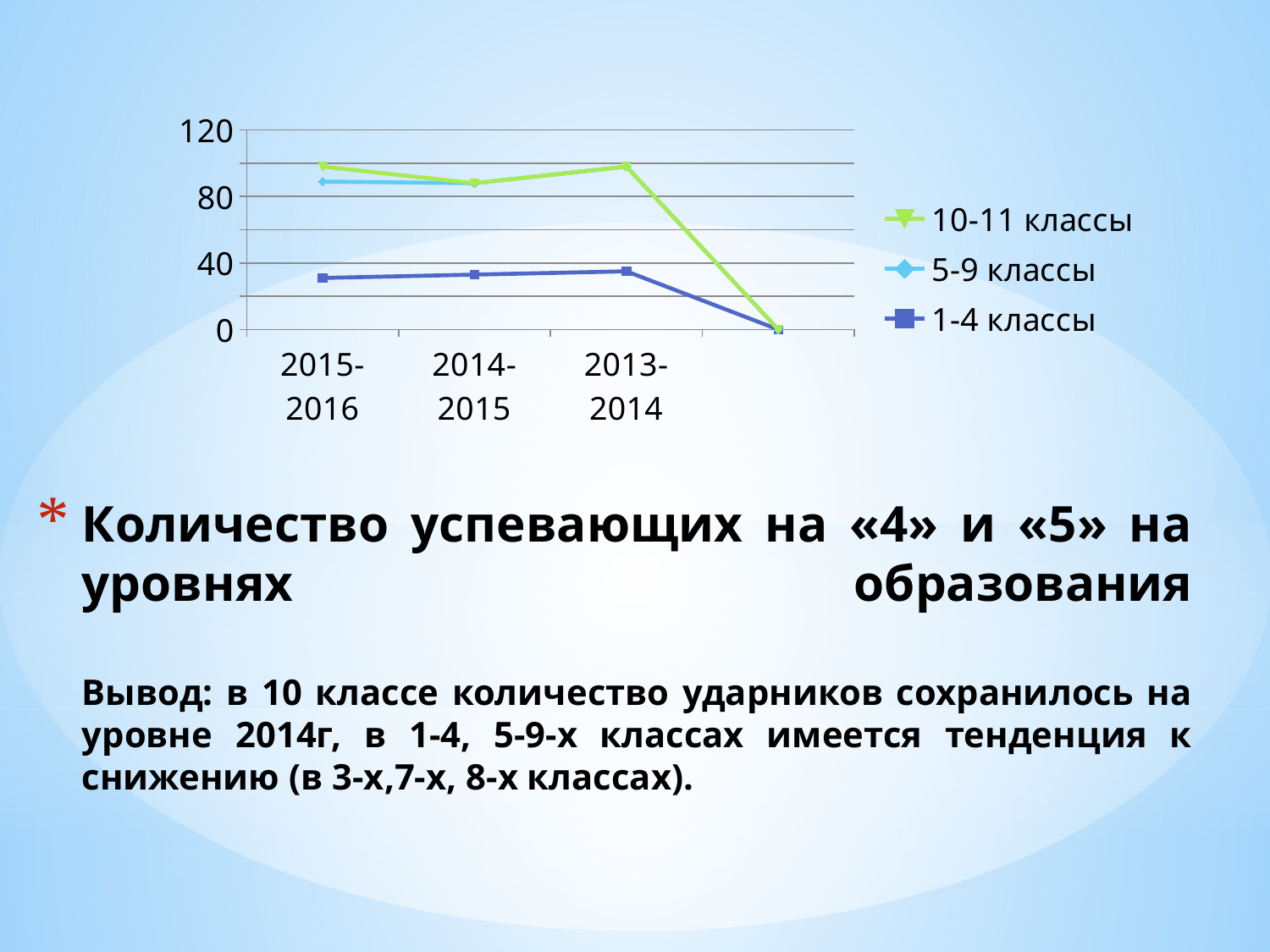
Which series has the larger value in 2015-2016, 5-9 классы or 1-4 классы? 5-9 классы Is the value for 1-4 классы in 2015-2016 greater or less than 40? less What colour is the line for 10-11 классы? green How many series does the legend list? 3 Is the value for 1-4 классы in 2013-2014 greater or less than 40? less How many school-year labels are shown on the x axis? 3 What are the three series named in the legend? 10-11 классы, 5-9 классы, 1-4 классы What kind of chart is shown on the slide? line chart Is the value for 5-9 классы in 2014-2015 greater or less than 40? greater